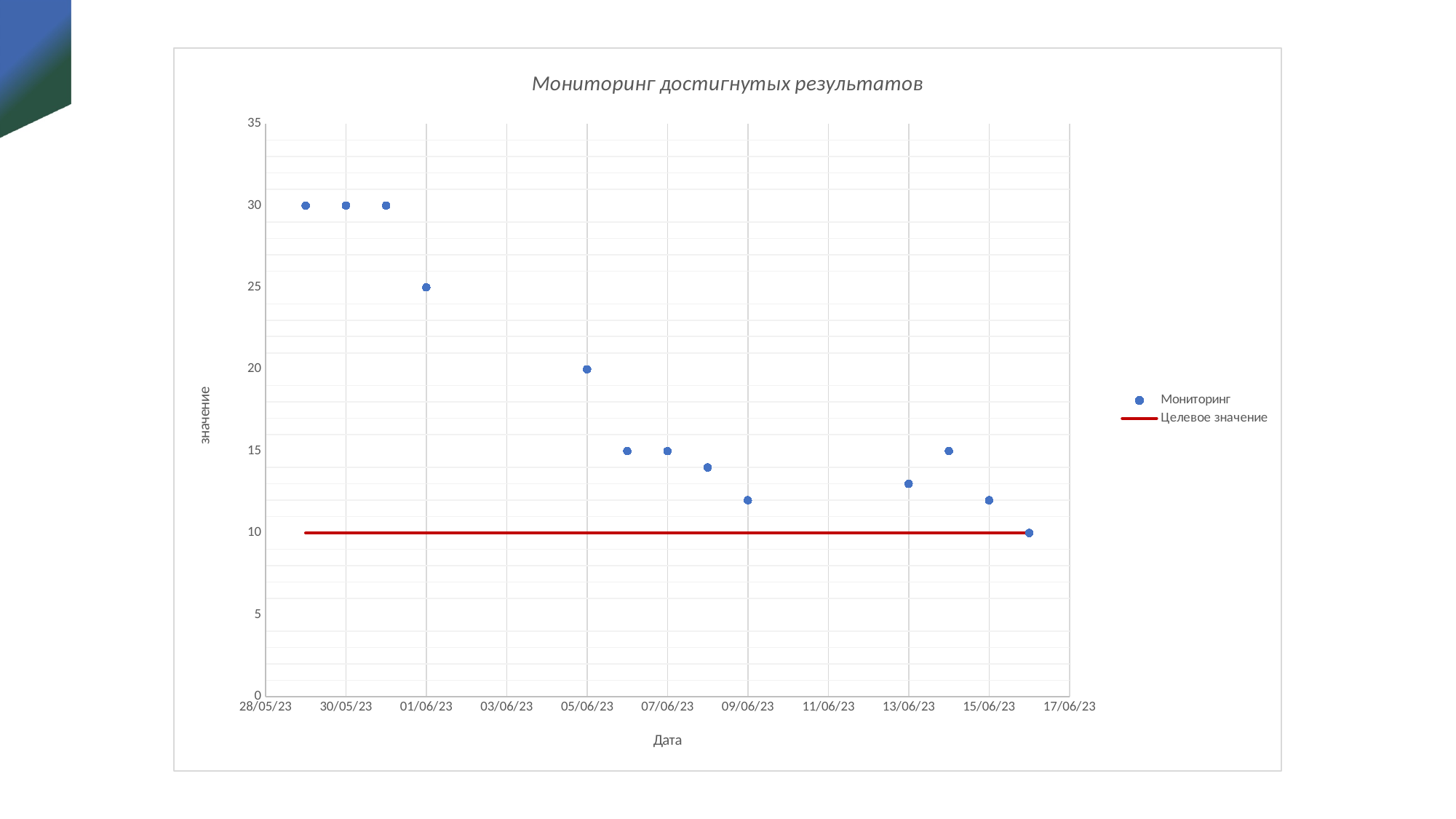
Which is larger, the Мониторинг value on 01/06/23 or on 05/06/23? 01/06/23 What is the Мониторинг value on 30/05/23? 30 What is the Мониторинг value on 07/06/23? 15 Do the Мониторинг values generally rise or fall over time along the x axis? fall At what level is the Целевое значение line drawn? 10 Is the Мониторинг value on 09/06/23 greater or less than 15? less What is the title of the chart? Мониторинг достигнутых результатов What is the Мониторинг value on 05/06/23? 20 How many series does the legend list? 2 What is the Мониторинг value on 01/06/23? 25 What are the two entries in the chart legend? Мониторинг, Целевое значение What kind of chart is shown on the slide? scatter chart